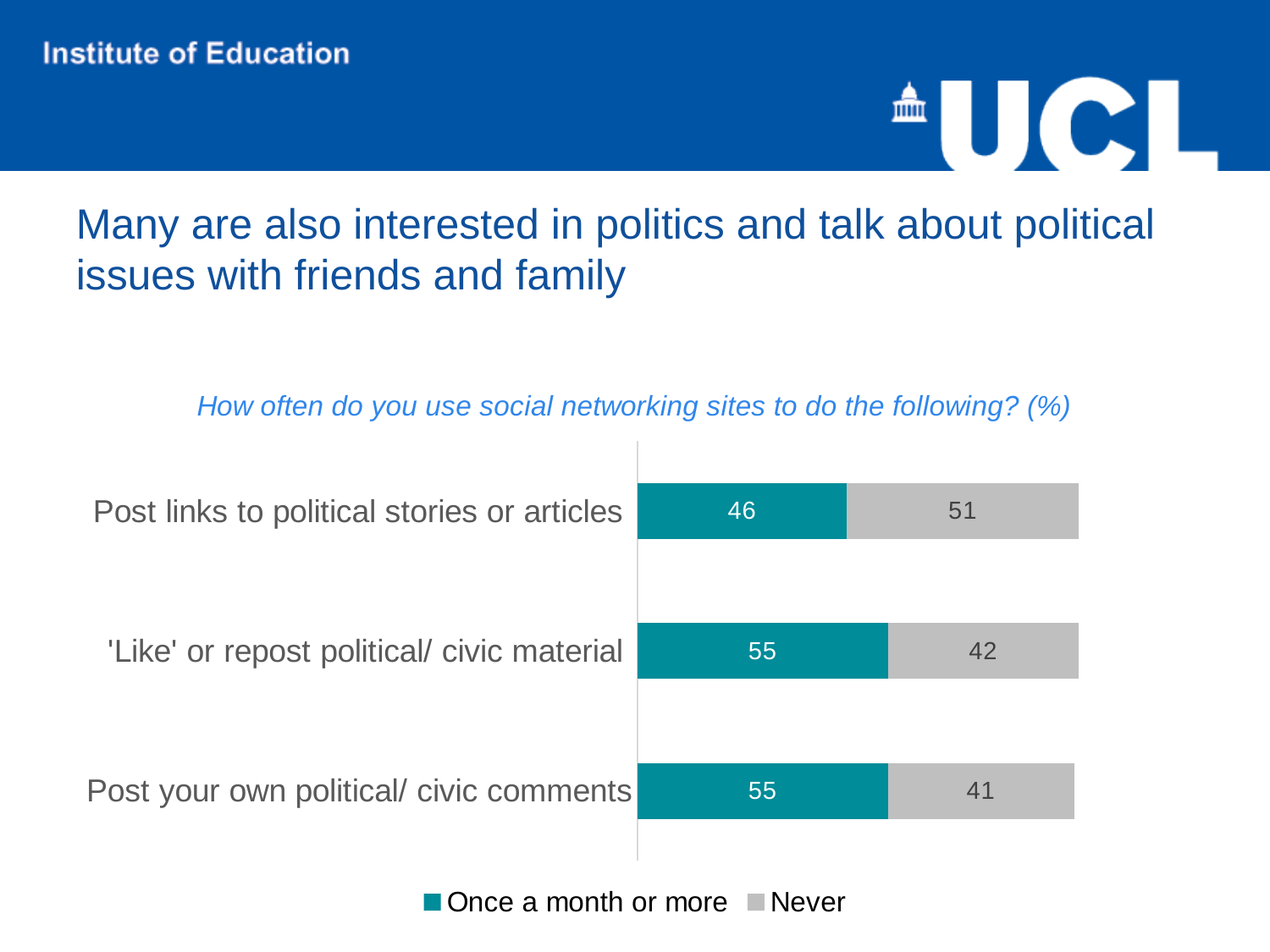
How many categories are shown in the chart? 3 What kind of chart is shown on the slide? Stacked bar chart What is the 'Never' value for ''Like' or repost political/ civic material'? 42 Which category has the highest 'Never' value? Post links to political stories or articles What is the 'Never' value for 'Post your own political/ civic comments'? 41 What is the 'Once a month or more' value for 'Post links to political stories or articles'? 46 What is the total of the stacked bar for ''Like' or repost political/ civic material'? 97 Which category has the lowest 'Once a month or more' value? Post links to political stories or articles What is the title of the chart? How often do you use social networking sites to do the following? (%) How many series does the legend list? 2 What is the difference between the 'Never' values for 'Post links to political stories or articles' and 'Post your own political/ civic comments'? 10 For 'Post links to political stories or articles', which is larger: 'Once a month or more' or 'Never'? Never